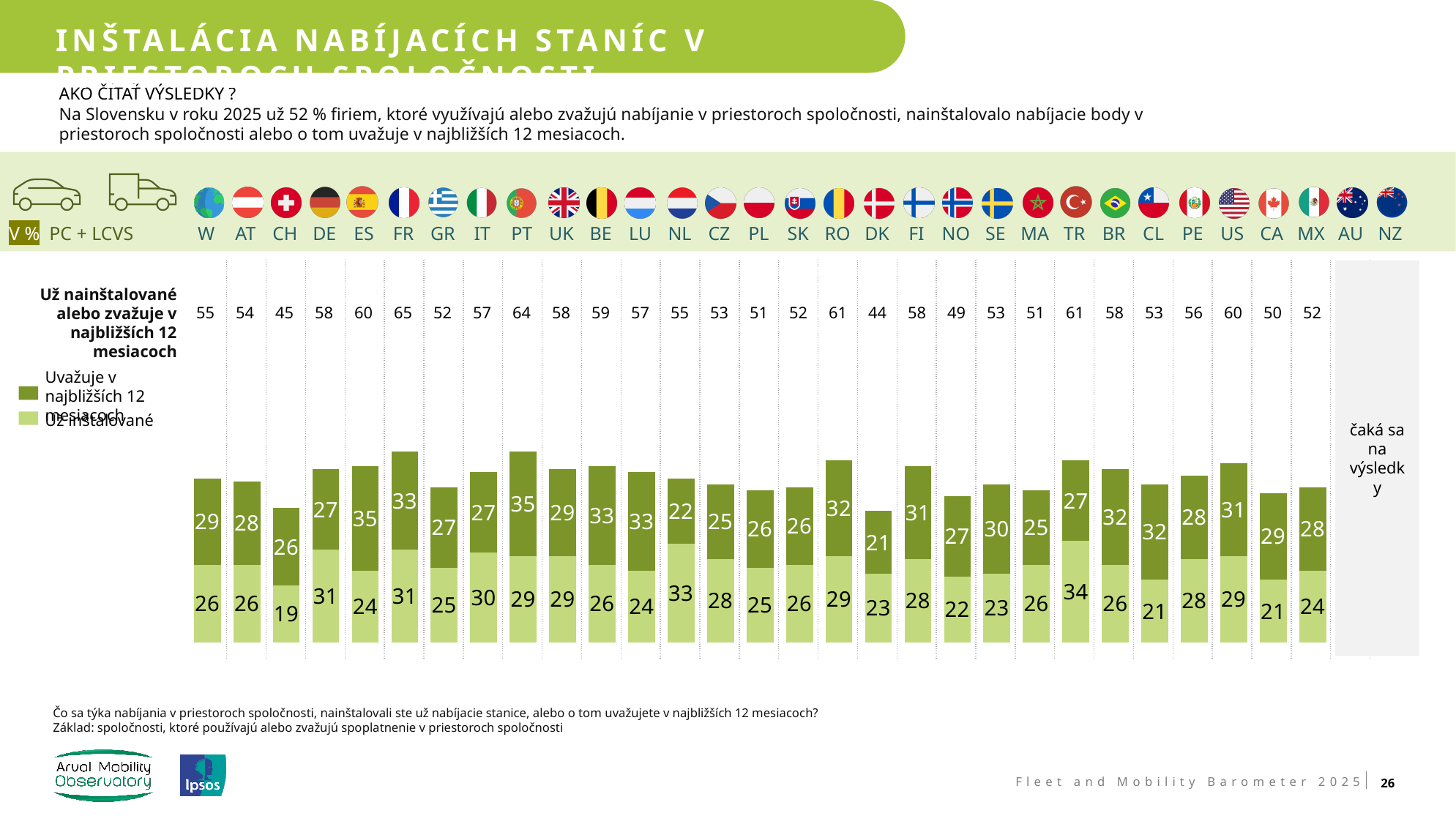
Which is larger, the 'Už inštalované' value for DE or for ES? DE What is the difference between the total values for PT and CH? 19 Which country has the highest total 'Už nainštalované alebo zvažuje v najbližších 12 mesiacoch' value? FR What kind of chart is shown on the slide? Stacked bar chart Which country has the lowest 'Už inštalované' value? CH How many series does the legend list? 2 Which country has the highest 'Už inštalované' value? TR What is the 'Už inštalované' value for SK? 26 Which country has the lowest total 'Už nainštalované alebo zvažuje v najbližších 12 mesiacoch' value? DK What is the total 'Už nainštalované alebo zvažuje v najbližších 12 mesiacoch' value shown for FR? 65 What is the 'Uvažuje v najbližších 12 mesiacoch' value for NL? 22 What is the total of the stacked bar for RO? 61